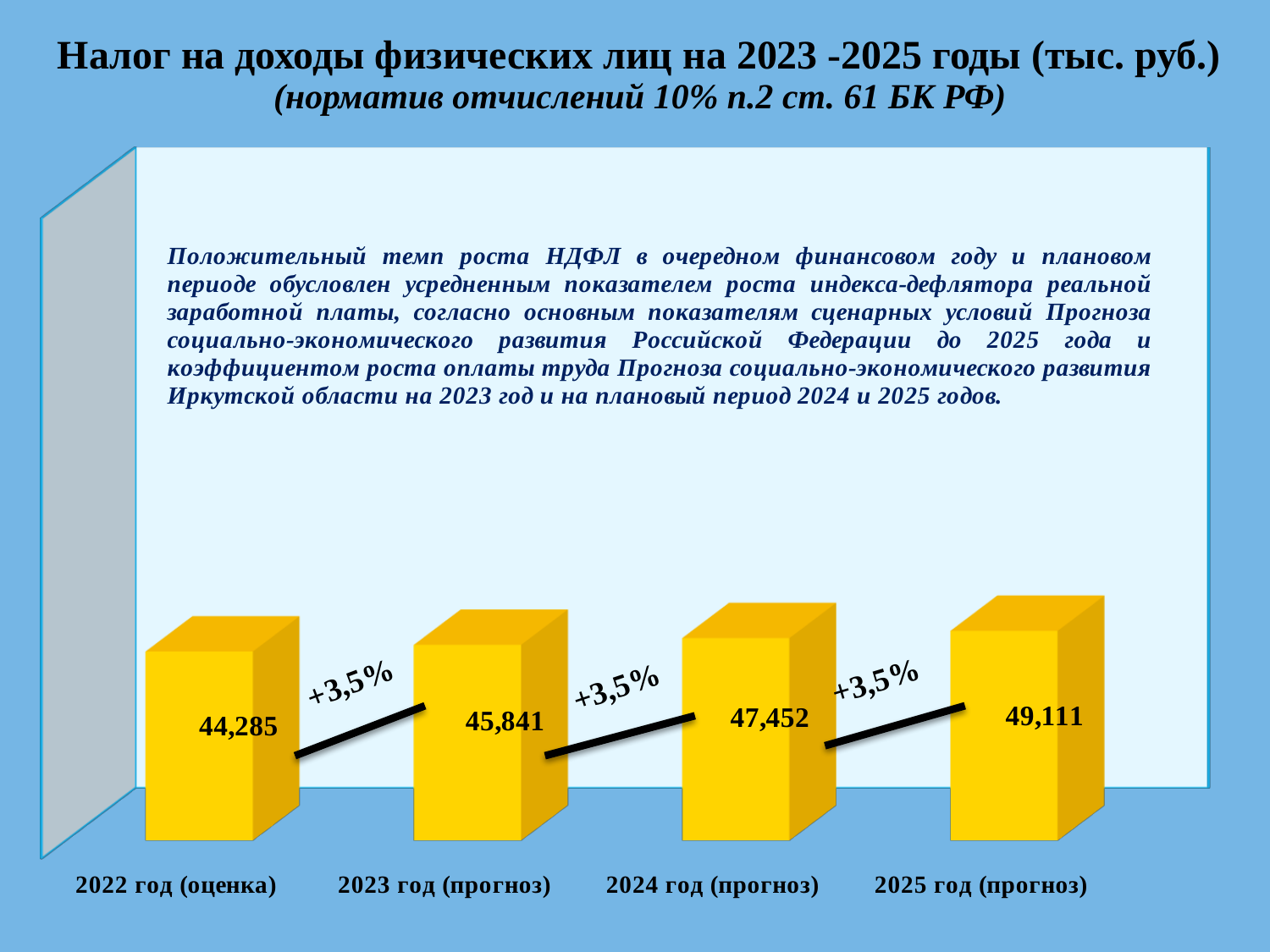
What is the value shown for 2025 год (прогноз)? 49,111 Which is larger, the value for 2024 год (прогноз) or the value for 2023 год (прогноз)? 2024 год (прогноз) What is the value shown for 2024 год (прогноз)? 47,452 What is the difference between the values for 2023 год (прогноз) and 2022 год (оценка)? 1,556 Which year has the lowest value on the chart? 2022 год (оценка) What kind of chart is shown on the slide? Bar chart What is the value shown for 2022 год (оценка)? 44,285 How many bars are shown on the chart? 4 Which year has the highest value on the chart? 2025 год (прогноз) What is the difference between the values for 2025 год (прогноз) and 2022 год (оценка)? 4,826 What is the value shown for 2023 год (прогноз)? 45,841 What growth percentage is labelled between each pair of consecutive bars? +3,5%